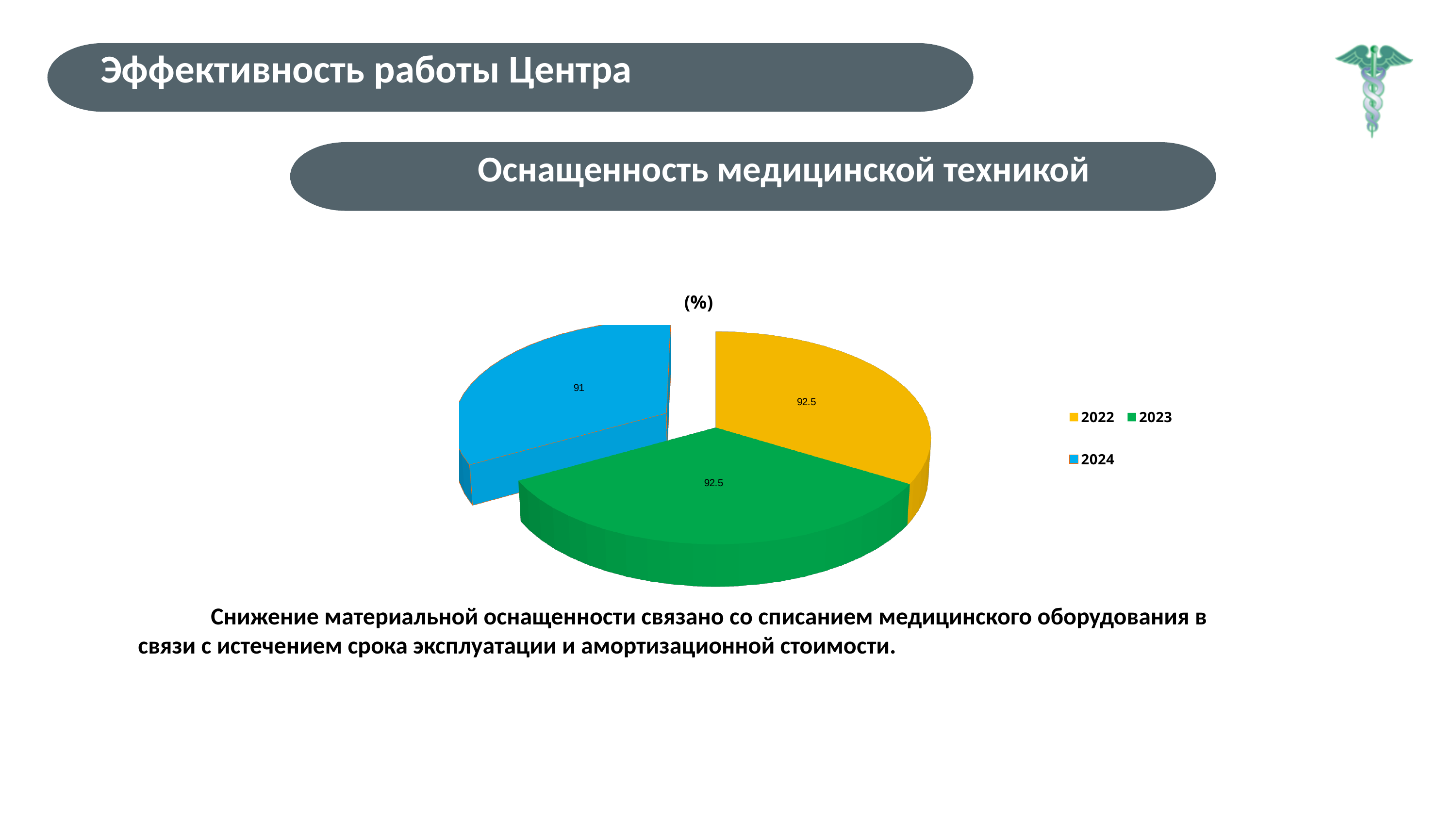
What is the value shown for 2022 in the pie chart? 92.5 Do the values for 2022 and 2023 differ? No, both are 92.5 What kind of chart is shown on the slide? Pie chart Which colour represents 2024 in the pie chart? Blue What is the value shown for 2024 in the pie chart? 91 How many entries does the chart legend list? 3 Which year has the lowest value in the pie chart? 2024 Which is larger, the value for 2023 or the value for 2024? 2023 What is the difference between the values for 2022 and 2024? 1.5 How many slices does the pie chart have? 3 What is the title printed above the pie chart? (%) What is the value shown for 2023 in the pie chart? 92.5